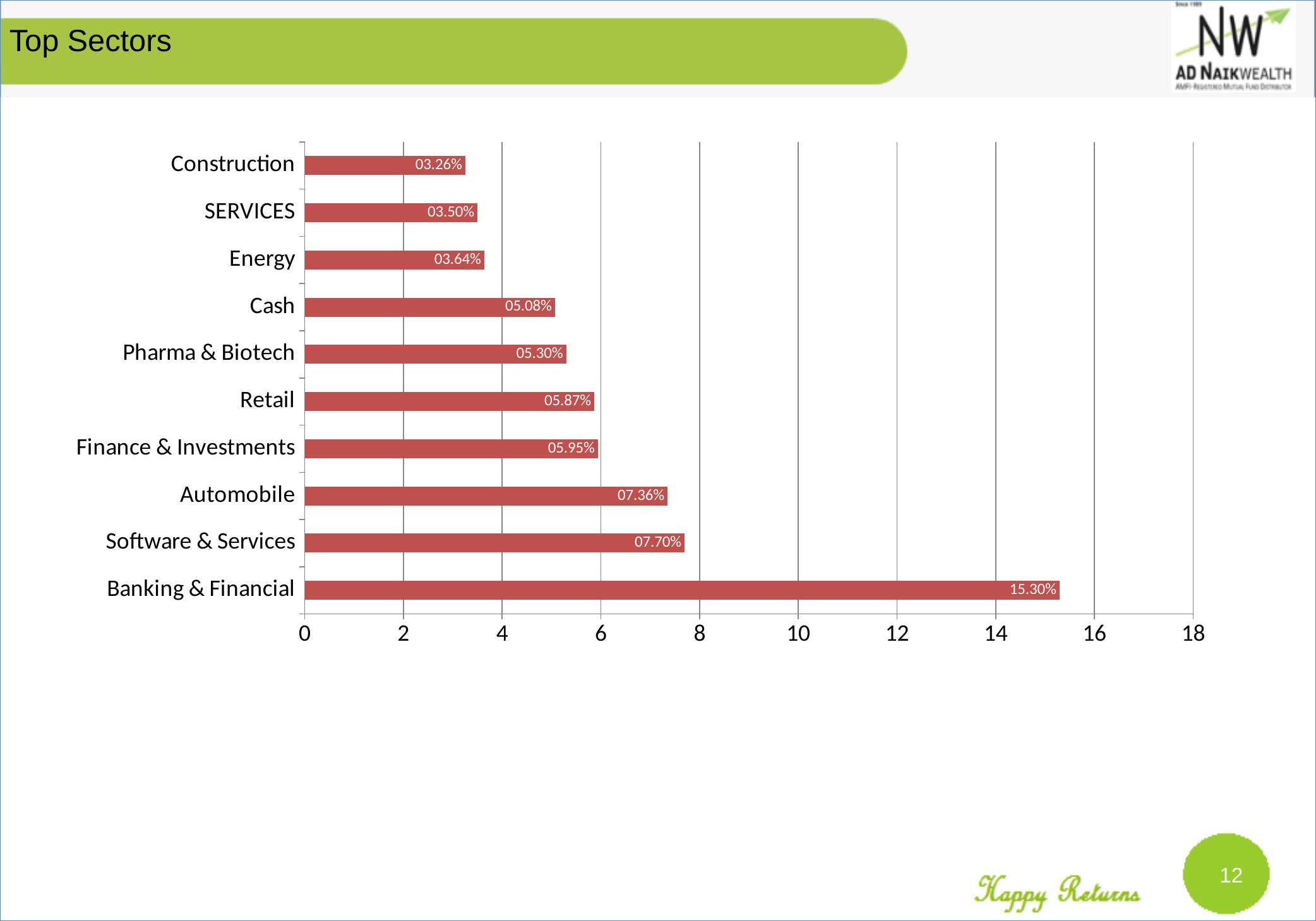
What is the value for Construction? 03.26% What is the title of the slide containing the chart? Top Sectors Is the value for Automobile greater or less than 6? greater What kind of chart is shown on the slide? bar chart What is the difference between the values for Automobile and Retail? 1.49% Which is larger, the value for Pharma & Biotech or the value for Energy? Pharma & Biotech What is the difference between the values for Banking & Financial and Software & Services? 7.60% How many sectors are shown in the chart? 10 What is the value for Banking & Financial? 15.30% Which sector has the lowest value? Construction What is the value for Cash? 05.08% Which sector has the highest value? Banking & Financial